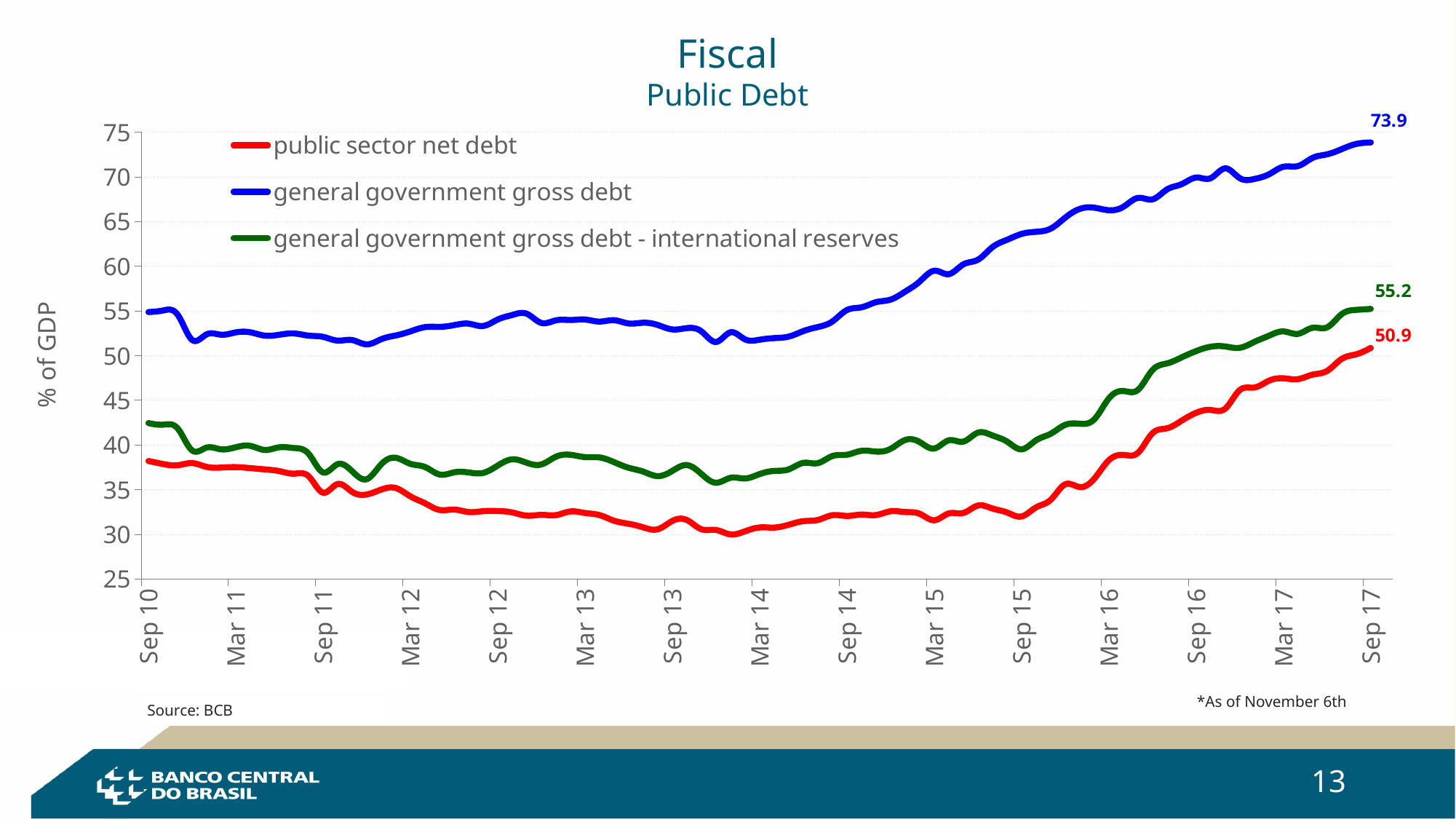
What is the value of general government gross debt - international reserves at Sep 17? 55.2 Which series has the highest value at Sep 17? general government gross debt Which series has the lowest value at Sep 17? public sector net debt What is the value of public sector net debt at Sep 17? 50.9 How many series does the legend list? 3 What is the value of general government gross debt at Sep 17? 73.9 What is the difference between general government gross debt and general government gross debt - international reserves at Sep 17? 18.7 Does general government gross debt rise or fall between Sep 14 and Sep 17? rise Is the value of public sector net debt at Sep 10 greater or less than 35? greater What kind of chart is shown on the slide? line chart What is the y-axis label of the chart? % of GDP What is the difference between general government gross debt and public sector net debt at Sep 17? 23.0